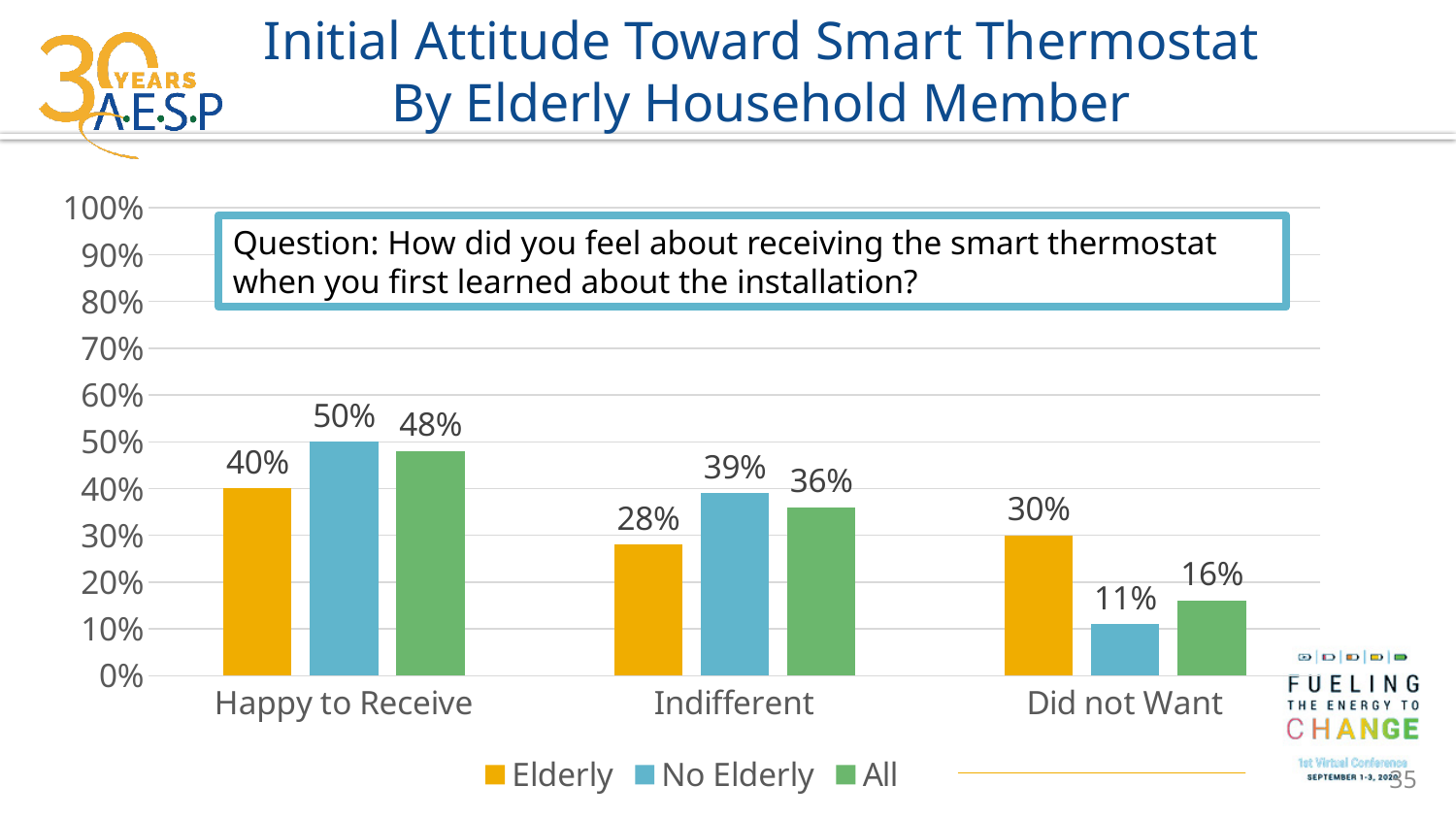
How many series does the legend list? 3 Which category has the lowest value for the Elderly series? Indifferent Is the value for No Elderly in the Did not Want category greater or less than 20%? less Which category has the highest value for the No Elderly series? Happy to Receive What percentage of Elderly households were Happy to Receive the smart thermostat? 40% How many categories are shown on the x axis? 3 What is the difference between the Elderly and No Elderly values in the Did not Want category? 19% What colour represents the Elderly series? Orange What is the value for All households in the Did not Want category? 16% What is the value for No Elderly households in the Indifferent category? 39% What kind of chart is shown on the slide? bar chart In the Indifferent category, which is larger: the Elderly value or the All value? All